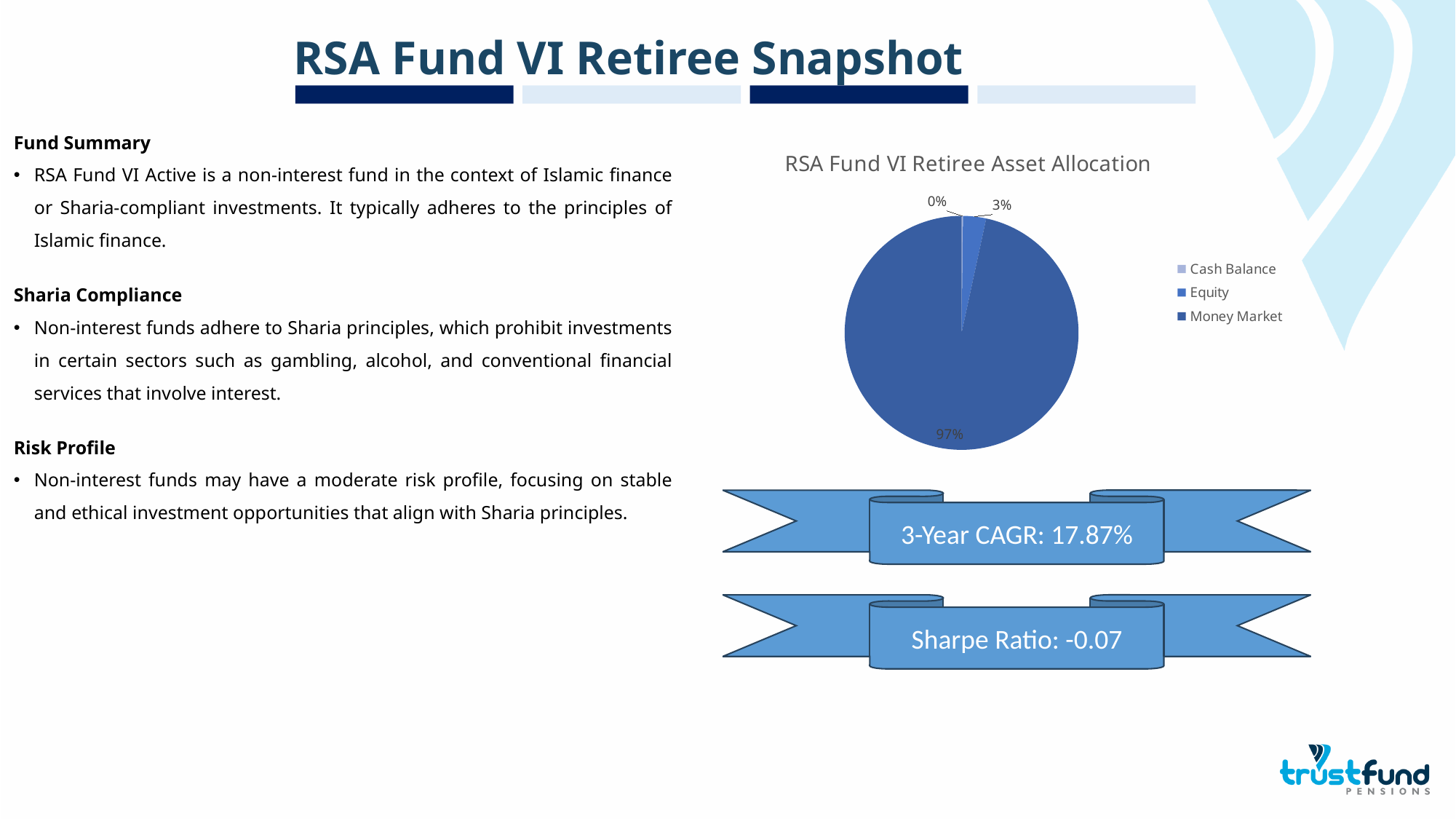
Which legend entry is shown in the darkest blue colour? Money Market What share of the pie does Cash Balance represent? 0% Which is larger, the Equity slice or the Money Market slice? Money Market What share of the pie does Equity represent? 3% What type of chart is shown on the slide? Pie chart Is the Money Market share greater or less than 50%? greater Which category has the smallest slice of the pie? Cash Balance What is the difference in percentage points between the Money Market and Equity slices? 94 What share of the pie does Money Market represent? 97% What is the title of the chart? RSA Fund VI Retiree Asset Allocation Which category has the largest slice of the pie? Money Market How many categories does the legend list? 3